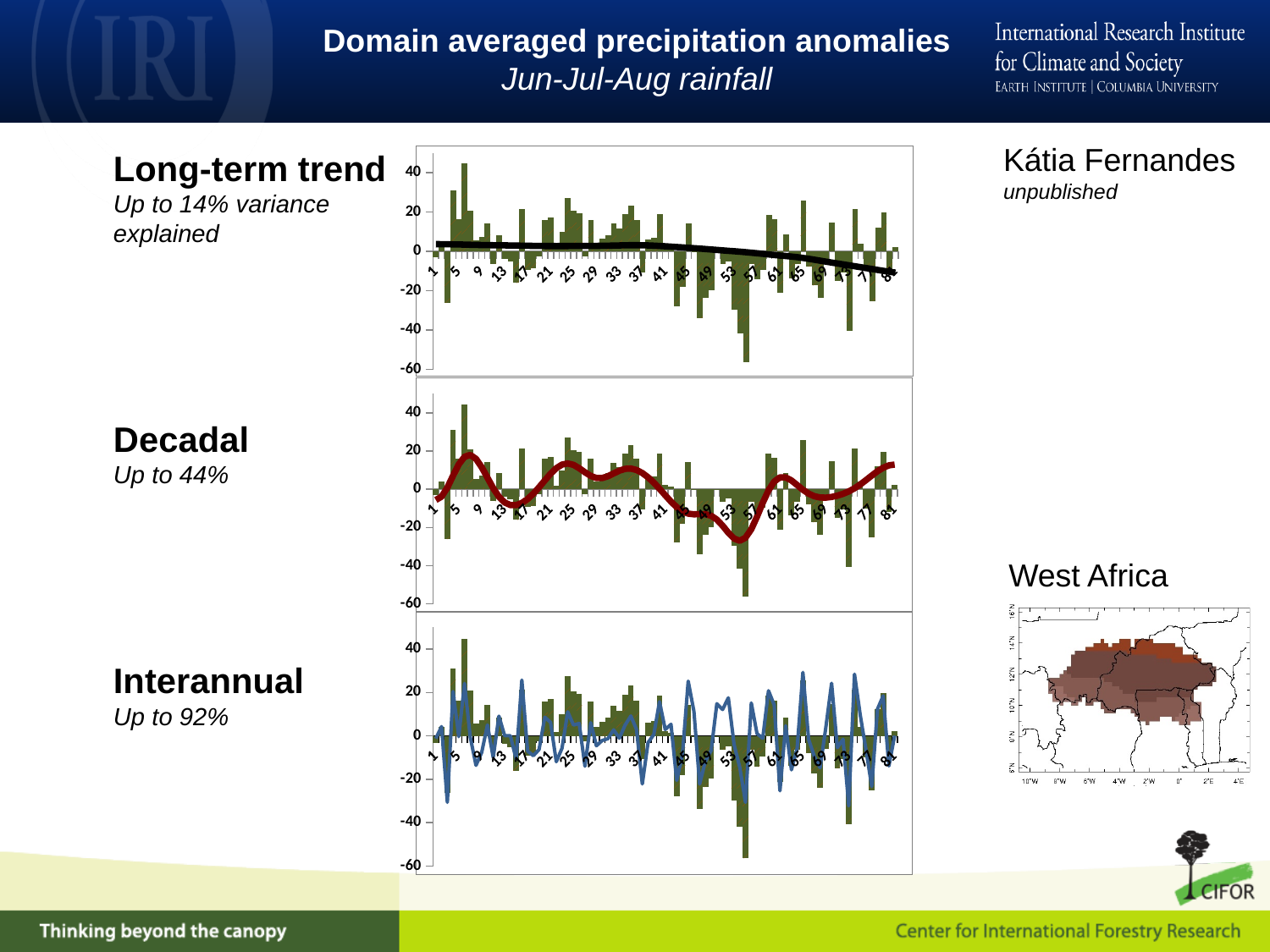
What is the lowest value labelled on the vertical axis of the Decadal chart? -60 In the Long-term trend chart, is the tallest bar greater or less than 40? greater In the Interannual chart, is the tallest bar greater or less than 20? greater In the Long-term trend chart, is the lowest bar greater or less than -40? less What kind of chart is the Long-term trend chart? combination bar and line chart What is the last label shown on the horizontal axis of the Interannual chart? 81 In the Long-term trend chart, does the black trend line rise or fall from left to right? fall What colour is the smoothed line overlaid on the Decadal chart? dark red How many charts are shown on the slide? 3